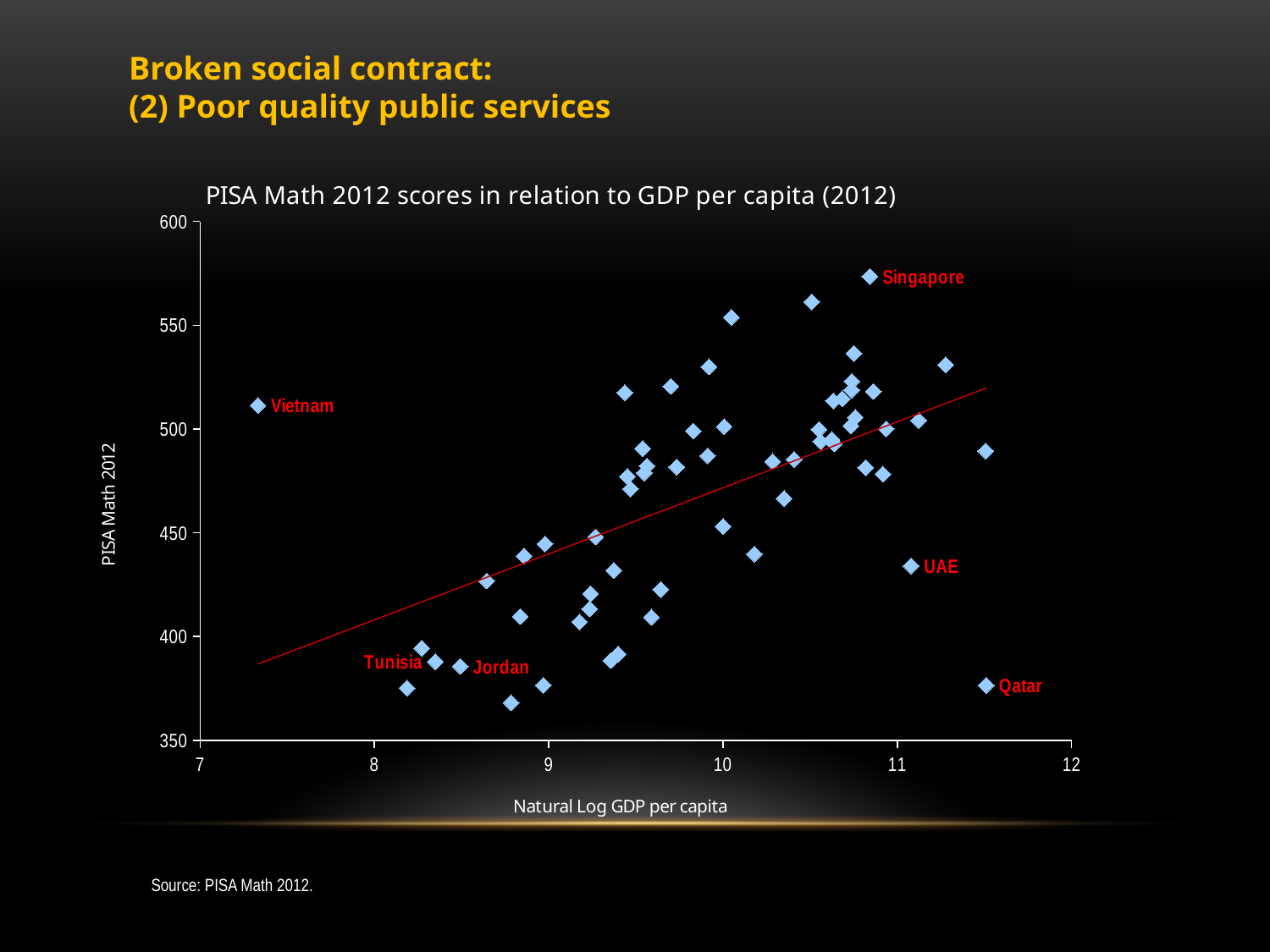
What kind of chart is shown on the slide? Scatter chart Is the PISA Math 2012 score for Qatar greater or less than 400? less Is the PISA Math 2012 score for Vietnam greater or less than 500? greater Is the Natural Log GDP per capita for Vietnam greater or less than 8? less What is the title of the chart? PISA Math 2012 scores in relation to GDP per capita (2012) Which has a higher PISA Math 2012 score, Vietnam or UAE? Vietnam According to the trend line, do PISA Math 2012 scores generally rise or fall as Natural Log GDP per capita increases? rise Which of the labelled countries has the highest PISA Math 2012 score? Singapore Which of the labelled countries has the lowest PISA Math 2012 score? Qatar What is the label of the x axis? Natural Log GDP per capita